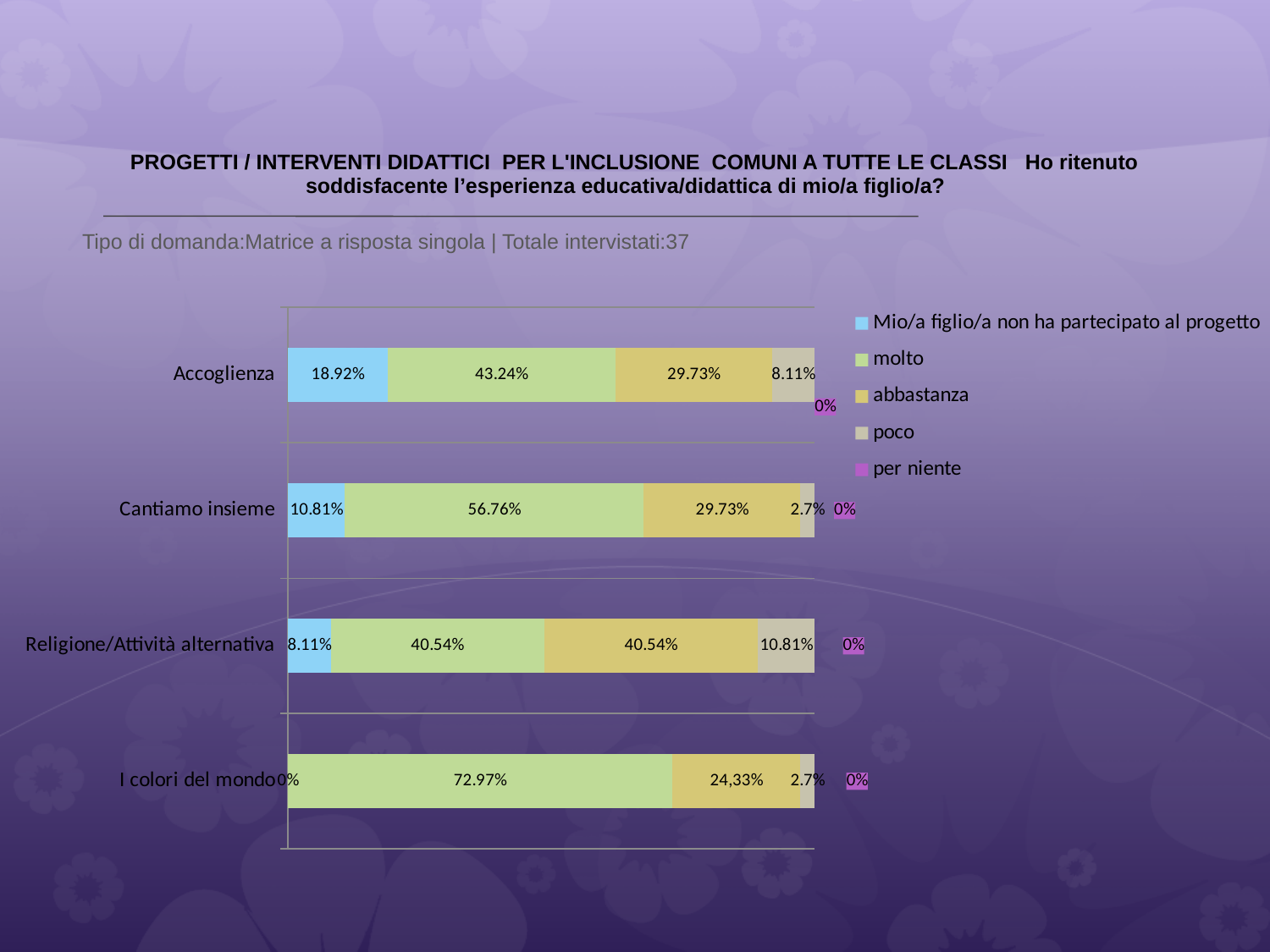
What kind of chart is shown on the slide? stacked bar chart How many series does the legend list? 5 What is the value of "molto" for Accoglienza? 43.24% Which category has the highest value for "molto"? I colori del mondo Which category has the lowest value for "molto"? Religione/Attività alternativa What is the value of "abbastanza" for Cantiamo insieme? 29.73% What is the value of "poco" for Religione/Attività alternativa? 10.81% What is the difference between "molto" and "abbastanza" for Accoglienza? 13.51% Which legend entry is shown in purple/magenta? per niente Which is larger for Cantiamo insieme: "molto" or "abbastanza"? molto What is the value of "Mio/a figlio/a non ha partecipato al progetto" for I colori del mondo? 0% How many categories (projects) are shown on the chart? 4